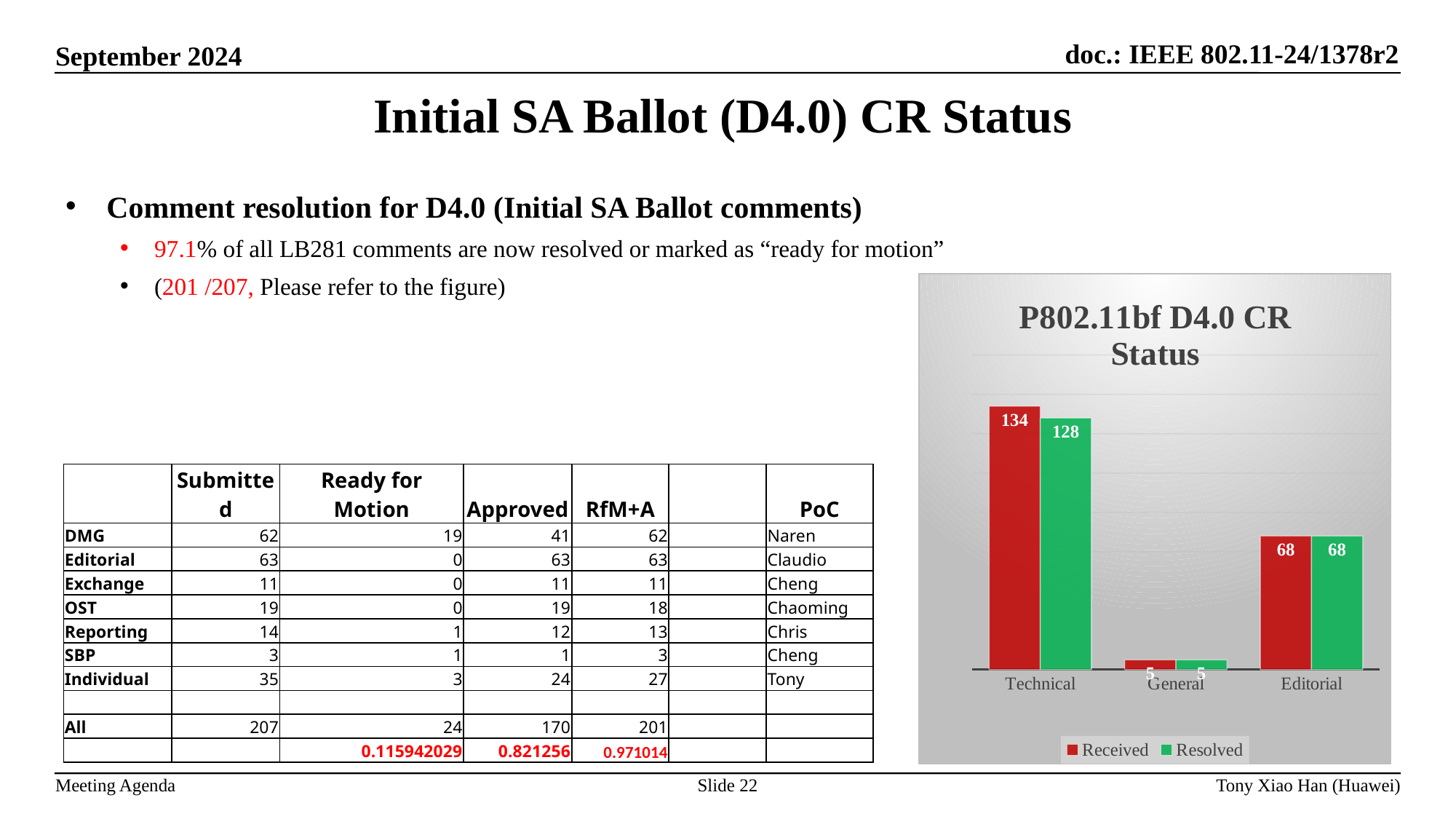
What is the Received value for Editorial in the P802.11bf D4.0 CR Status chart? 68 What kind of chart is the P802.11bf D4.0 CR Status chart? bar chart Which series in the P802.11bf D4.0 CR Status chart is shown in green? Resolved In the P802.11bf D4.0 CR Status chart, is the Received value for Technical larger or smaller than the Received value for Editorial? larger Which category has the highest Received value in the P802.11bf D4.0 CR Status chart? Technical What is the Received value for Technical in the P802.11bf D4.0 CR Status chart? 134 What is the difference between the Received and Resolved values for Technical in the P802.11bf D4.0 CR Status chart? 6 Which category has the lowest Resolved value in the P802.11bf D4.0 CR Status chart? General How many categories are shown on the x axis of the P802.11bf D4.0 CR Status chart? 3 What is the Resolved value for Technical in the P802.11bf D4.0 CR Status chart? 128 What is the Resolved value for General in the P802.11bf D4.0 CR Status chart? 5 How many series does the legend of the P802.11bf D4.0 CR Status chart list? 2